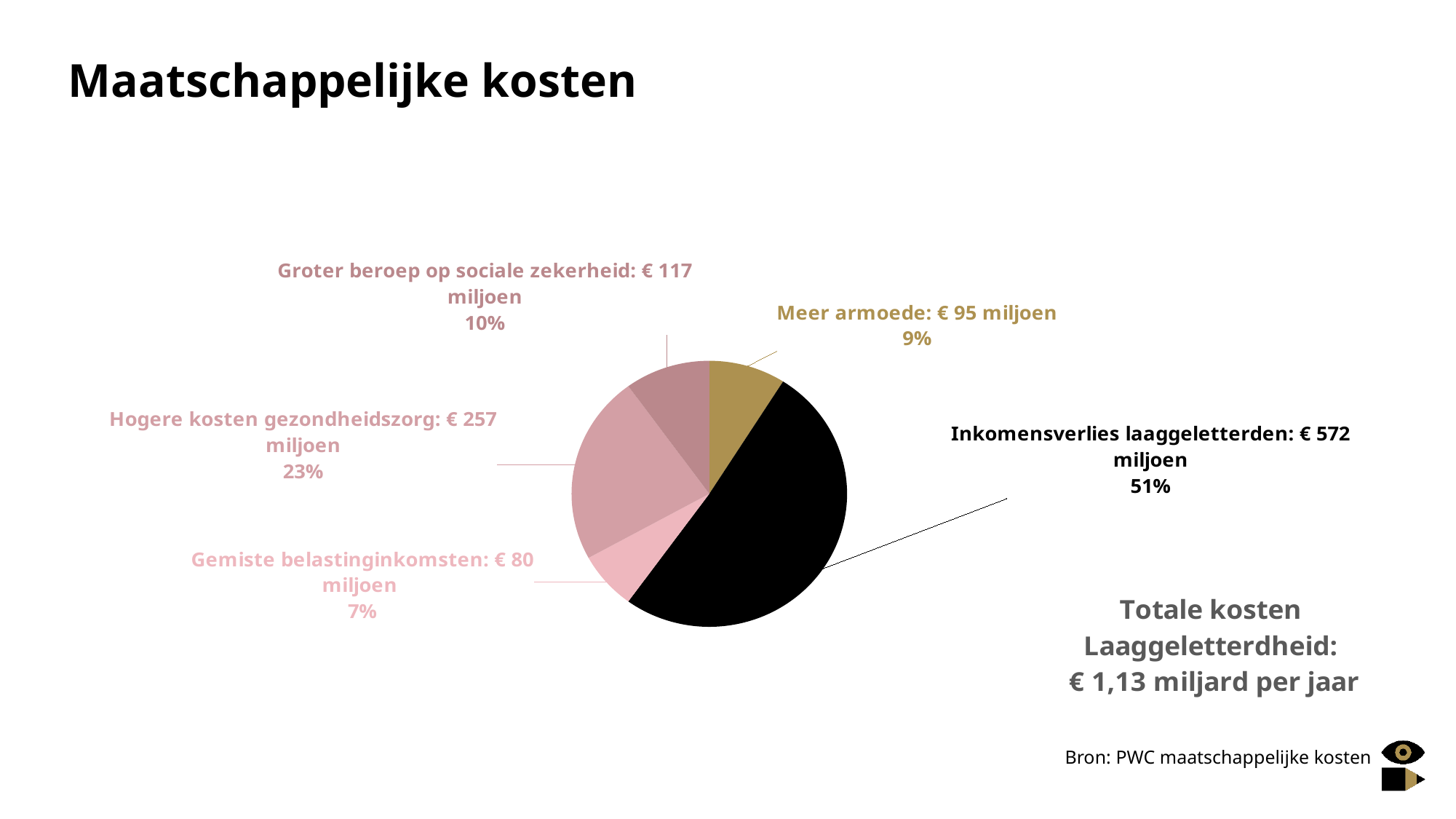
Which category has the largest slice of the pie? Inkomensverlies laaggeletterden What is the value for Meer armoede? € 95 miljoen What share of the pie does Groter beroep op sociale zekerheid represent? 10% What is the title of the slide containing the pie chart? Maatschappelijke kosten What is the value for Inkomensverlies laaggeletterden? € 572 miljoen What share of the pie does Gemiste belastinginkomsten represent? 7% What is the difference between the values for Inkomensverlies laaggeletterden and Hogere kosten gezondheidszorg? € 315 miljoen How many slices does the pie chart have? 5 What kind of chart is shown on the slide? pie chart What is the value for Hogere kosten gezondheidszorg? € 257 miljoen Which category has the smallest slice of the pie? Gemiste belastinginkomsten Which is larger, the value for Groter beroep op sociale zekerheid or the value for Meer armoede? Groter beroep op sociale zekerheid